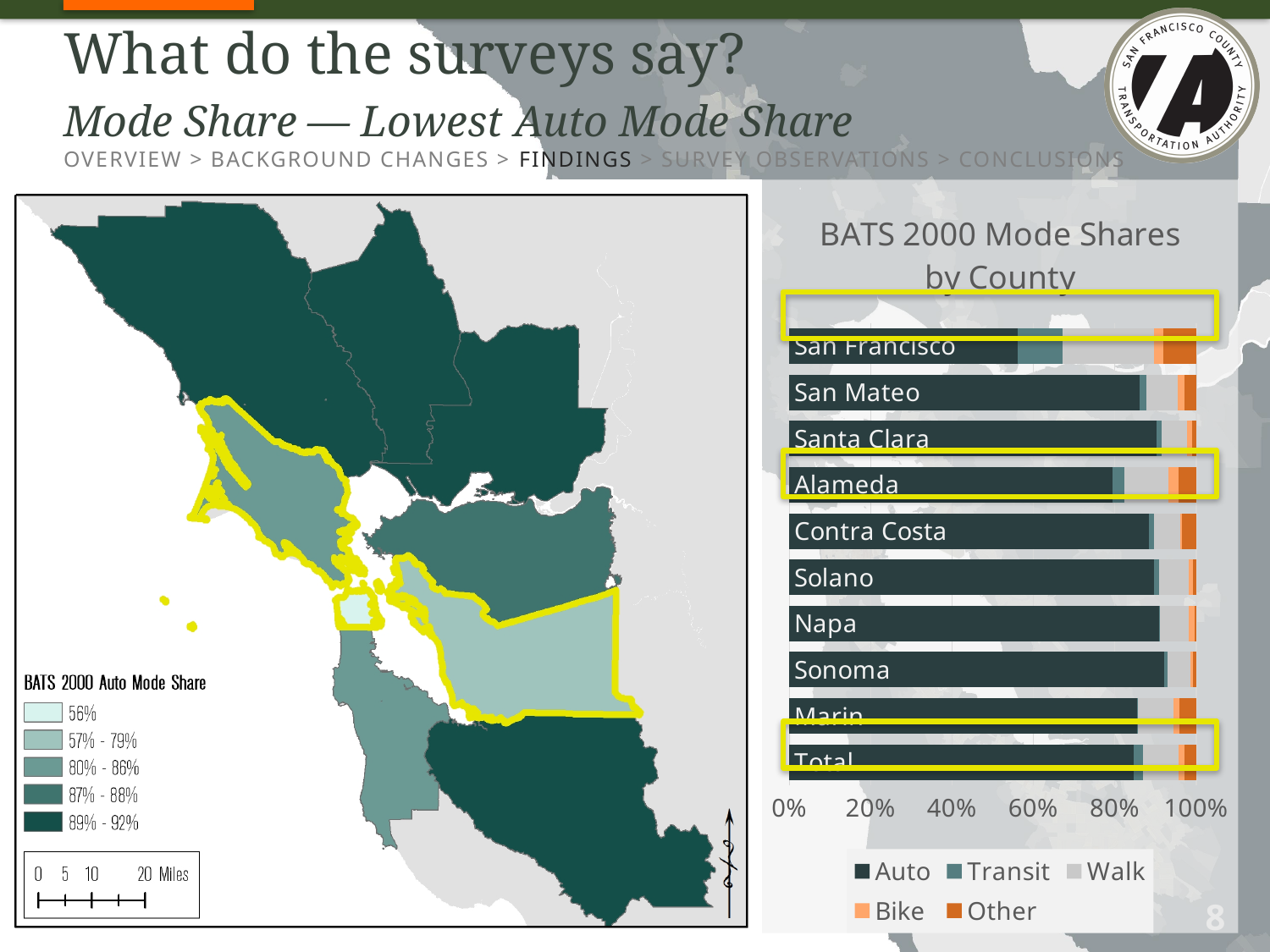
Is the Auto share for San Francisco greater or less than 60%? less Is the Auto share for Napa greater or less than 80%? greater Which has the larger Auto share, San Francisco or San Mateo? San Mateo Which county has the lowest Auto share in the BATS 2000 Mode Shares by County chart? San Francisco What is the highest value labelled on the x axis of the BATS 2000 Mode Shares by County chart? 100% What kind of chart is the BATS 2000 Mode Shares by County chart? bar chart Which has the larger Auto share, Alameda or Napa? Napa Which county has the largest Transit share in the BATS 2000 Mode Shares by County chart? San Francisco Is the Auto share for Alameda greater or less than 60%? greater How many counties or categories are listed on the BATS 2000 Mode Shares by County chart? 10 What is the title of the bar chart on the slide? BATS 2000 Mode Shares by County How many series does the legend of the BATS 2000 Mode Shares by County chart list? 5